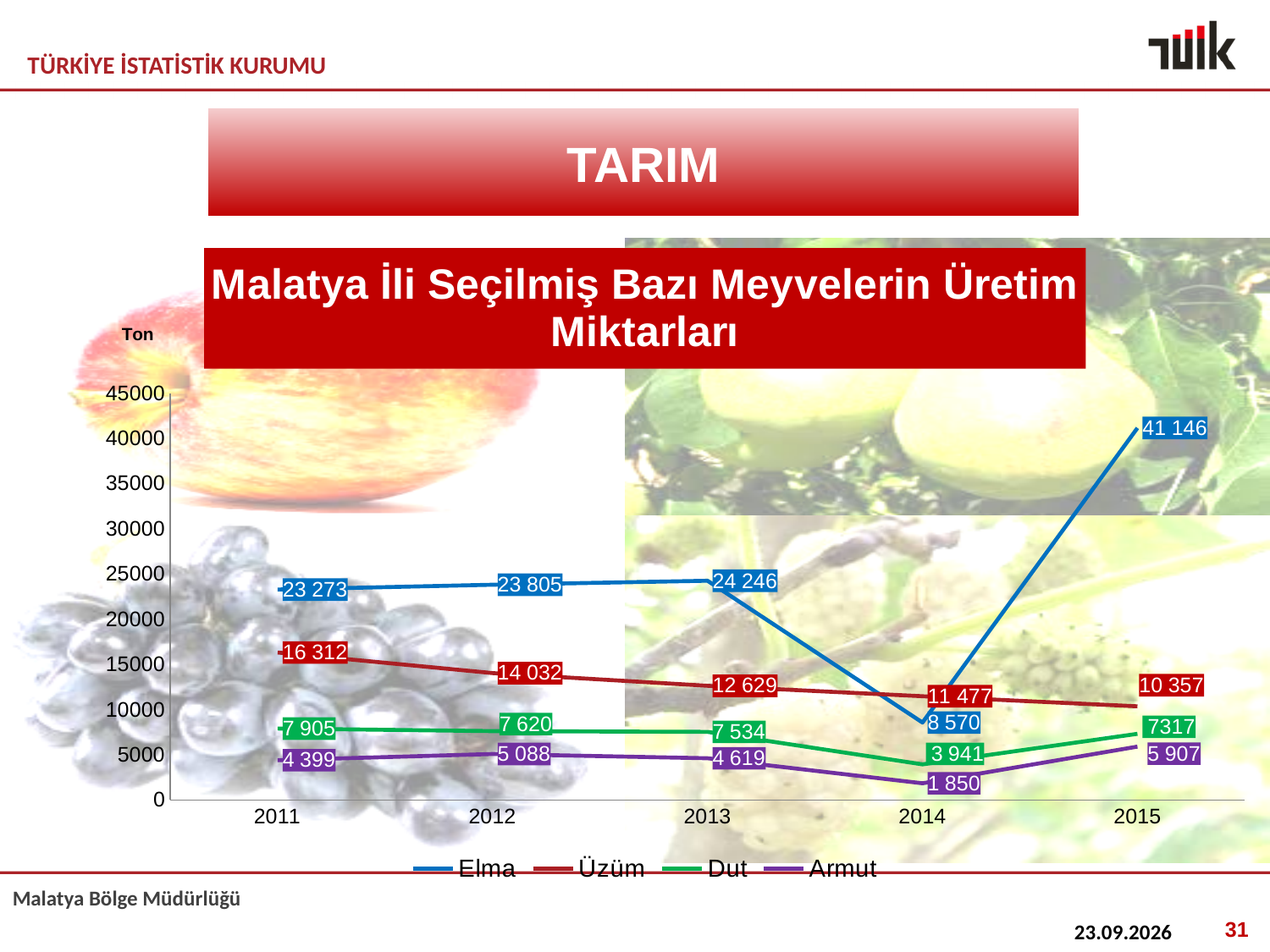
How many years are shown on the x axis? 5 Which is larger in 2014, the Üzüm value or the Elma value? Üzüm What is the Üzüm value for 2013? 12 629 What is the Armut value for 2014? 1 850 What kind of chart is shown on the slide? line chart What is the Dut value for 2012? 7 620 What is the difference between the Elma values for 2015 and 2014? 32 576 In which year is the Elma value lowest? 2014 What is the Elma value for 2015? 41 146 How many series does the legend list? 4 Does the Üzüm value rise or fall from 2011 to 2015? fall In which year is the Üzüm value highest? 2011